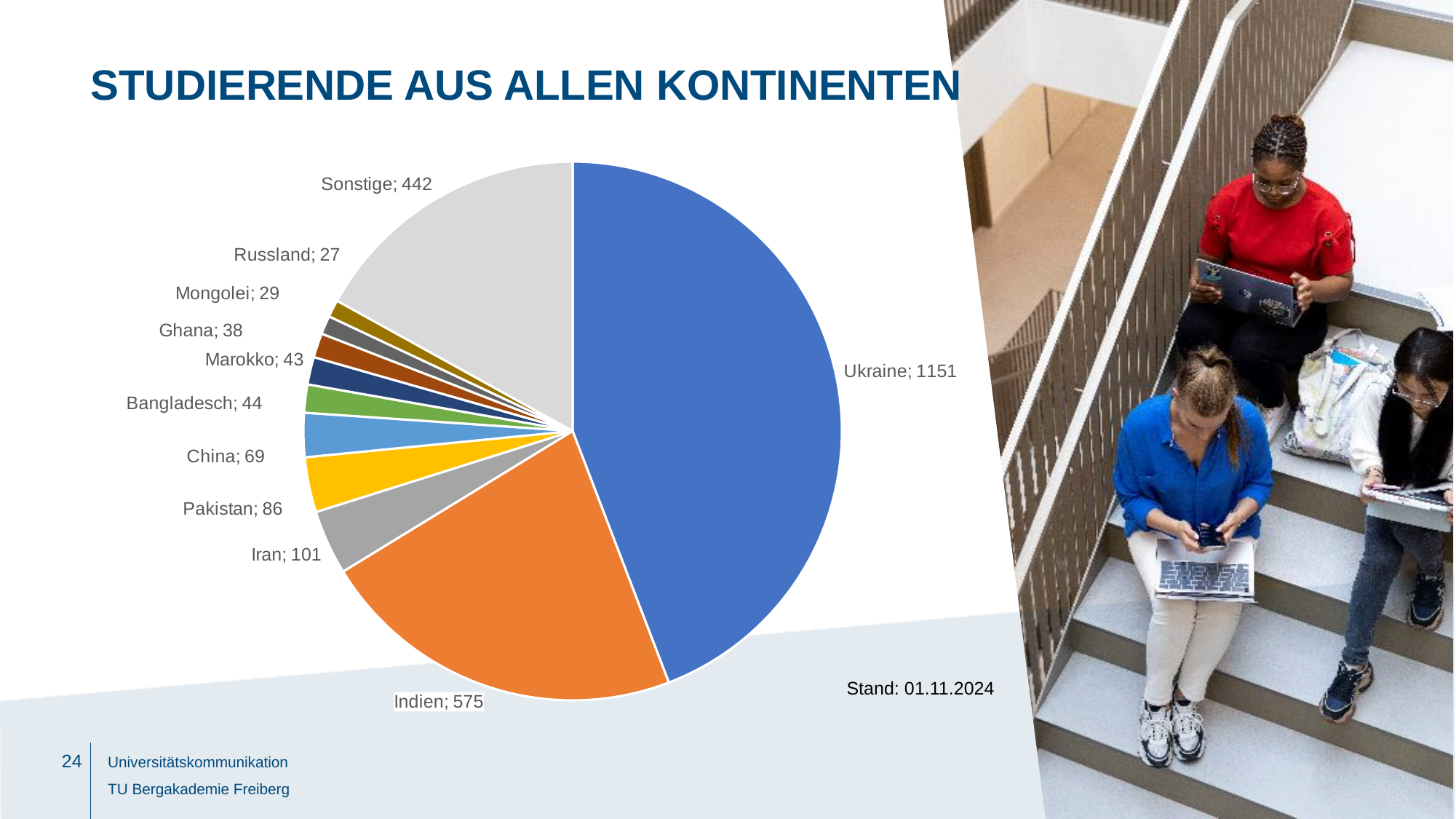
What kind of chart is shown on the slide? pie chart What is the difference between the values for Ukraine and Indien? 576 Which is larger, the value for China or the value for Ghana? China What is the value for Ukraine in the pie chart? 1151 Which category has the largest slice in the pie chart? Ukraine How many slices does the pie chart have? 11 What is the value for Sonstige in the pie chart? 442 What is the value for Indien in the pie chart? 575 What is the difference between the values for Iran and Pakistan? 15 What is the title of the slide containing the pie chart? STUDIERENDE AUS ALLEN KONTINENTEN What is the value for Bangladesch in the pie chart? 44 Which category has the smallest slice in the pie chart? Russland